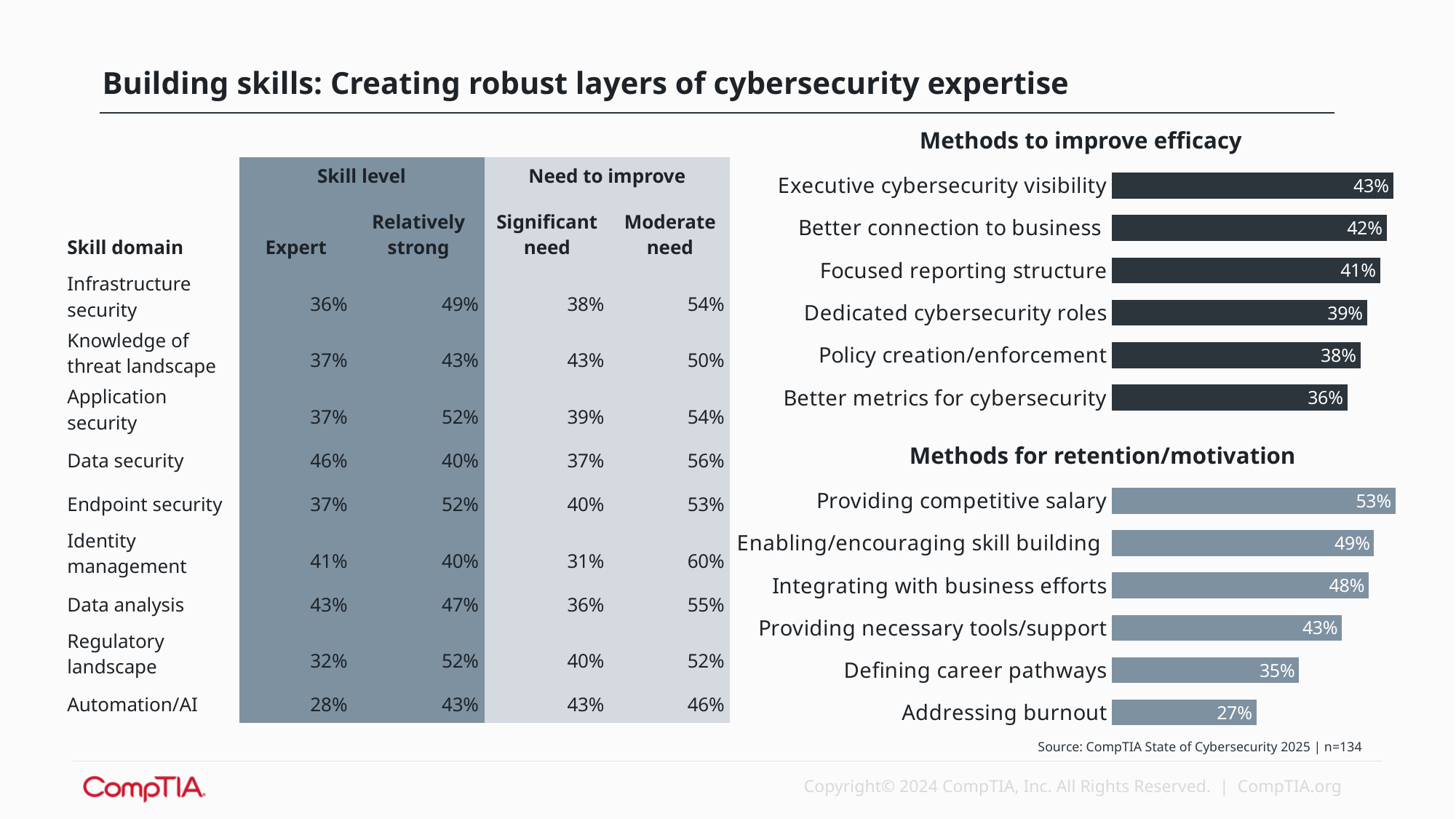
In the 'Methods for retention/motivation' chart, which method has the lowest value? Addressing burnout In the 'Methods to improve efficacy' chart, how many methods are shown? 6 In the 'Methods for retention/motivation' chart, what is the value for Defining career pathways? 35% In the 'Methods to improve efficacy' chart, what is the value for Executive cybersecurity visibility? 43% In the 'Methods for retention/motivation' chart, what is the value for Providing competitive salary? 53% In the 'Methods to improve efficacy' chart, what is the difference between Executive cybersecurity visibility and Better metrics for cybersecurity? 7% In the 'Methods to improve efficacy' chart, which method has the lowest value? Better metrics for cybersecurity In the 'Methods for retention/motivation' chart, which method has the highest value? Providing competitive salary In the 'Methods for retention/motivation' chart, which is larger: Integrating with business efforts or Providing necessary tools/support? Integrating with business efforts In the 'Methods for retention/motivation' chart, what is the difference between Providing competitive salary and Addressing burnout? 26% What type of chart is 'Methods for retention/motivation'? Bar chart In the 'Methods to improve efficacy' chart, what is the value for Policy creation/enforcement? 38%